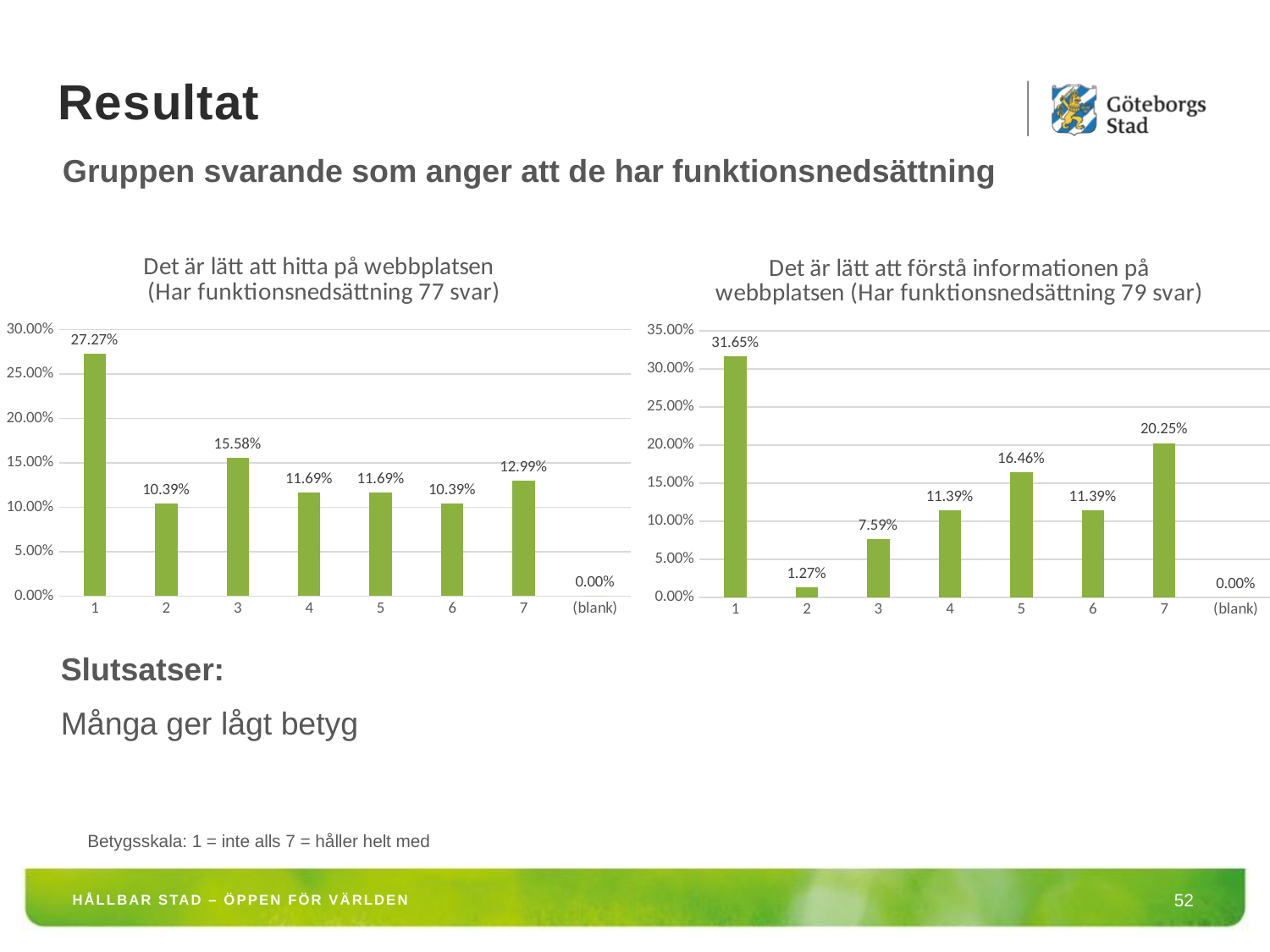
In the left chart 'Det är lätt att hitta på webbplatsen', which is larger: the value for category 3 or the value for category 7? 3 In the left chart 'Det är lätt att hitta på webbplatsen', which category has the highest value? 1 How many categories are shown on the x axis of the left chart 'Det är lätt att hitta på webbplatsen'? 8 In the left chart 'Det är lätt att hitta på webbplatsen', what is the difference between the values for category 1 and category 2? 16.88% In the left chart 'Det är lätt att hitta på webbplatsen', what is the value for category 1? 27.27% In the right chart 'Det är lätt att förstå informationen på webbplatsen', what is the value for category 2? 1.27% In the right chart 'Det är lätt att förstå informationen på webbplatsen', what is the difference between the values for category 1 and category 7? 11.40% What kind of chart is the right chart 'Det är lätt att förstå informationen på webbplatsen'? Bar chart How many respondents does the title of the right chart 'Det är lätt att förstå informationen på webbplatsen' state? 79 svar In the left chart 'Det är lätt att hitta på webbplatsen', what is the value for category 3? 15.58% In the right chart 'Det är lätt att förstå informationen på webbplatsen', is the value for category 5 greater or less than 15.00%? greater In the right chart 'Det är lätt att förstå informationen på webbplatsen', which category has the lowest non-zero value? 2